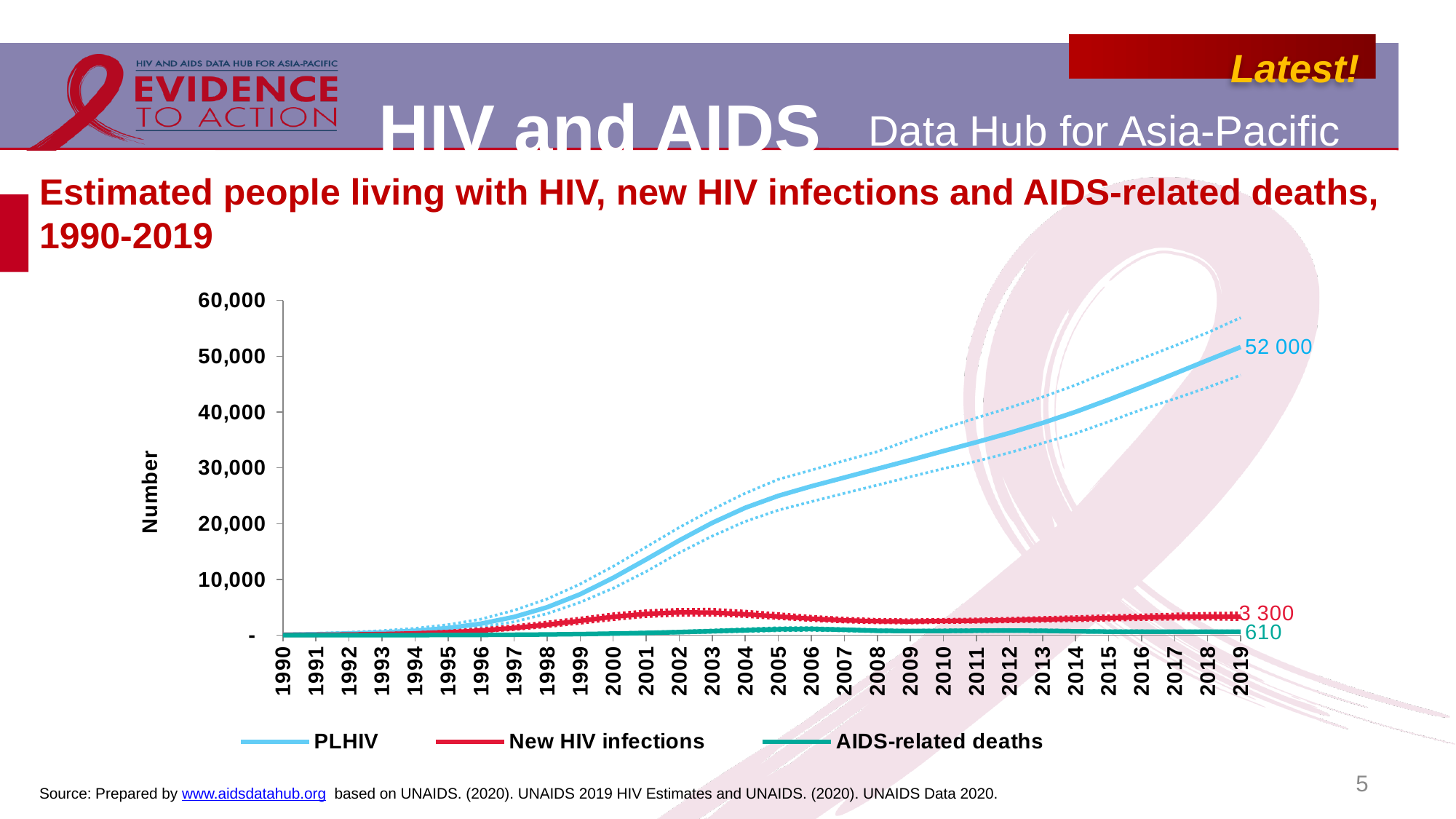
Is the value for PLHIV in 2010 greater or less than 40,000? less Is the value for PLHIV in 2005 greater or less than 20,000? greater What is the value for New HIV infections in 2019? 3 300 Which series has the highest value in 2019? PLHIV What is the value for PLHIV in 2019? 52 000 What is the difference between the PLHIV value and the New HIV infections value in 2019? 48 700 What kind of chart is shown on the slide? Line chart What is the value for AIDS-related deaths in 2019? 610 Does the PLHIV line rise or fall from 1990 to 2019? Rises In 2019, which is larger: New HIV infections or AIDS-related deaths? New HIV infections Which series has the lowest value in 2019? AIDS-related deaths How many series does the legend list? 3